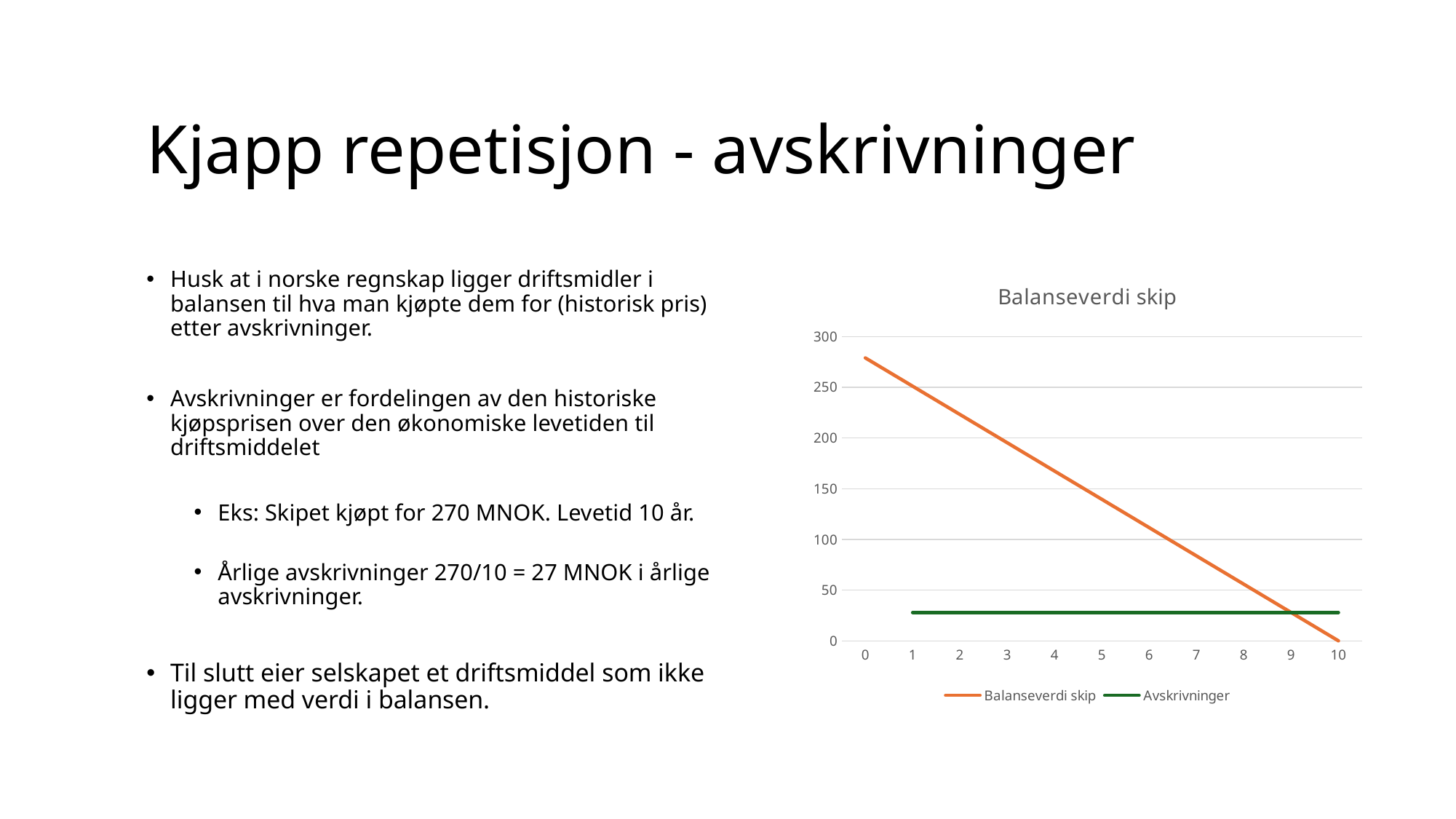
Is the value of Avskrivninger at year 5 greater or less than 50? less Does the Balanseverdi skip line rise or fall as the year increases from 0 to 10? fall At year 10, which series has the larger value, Balanseverdi skip or Avskrivninger? Avskrivninger How many series does the chart legend list? 2 What is the title of the chart? Balanseverdi skip What kind of chart is shown on the slide? line chart Which colour is used for the Avskrivninger series? green At which year is the Balanseverdi skip value lowest? 10 Is the value of Balanseverdi skip at year 0 greater or less than 250? greater At which year is the Balanseverdi skip value highest? 0 What is the value of Balanseverdi skip at year 10? 0 Is the value of Balanseverdi skip at year 7 greater or less than 100? less